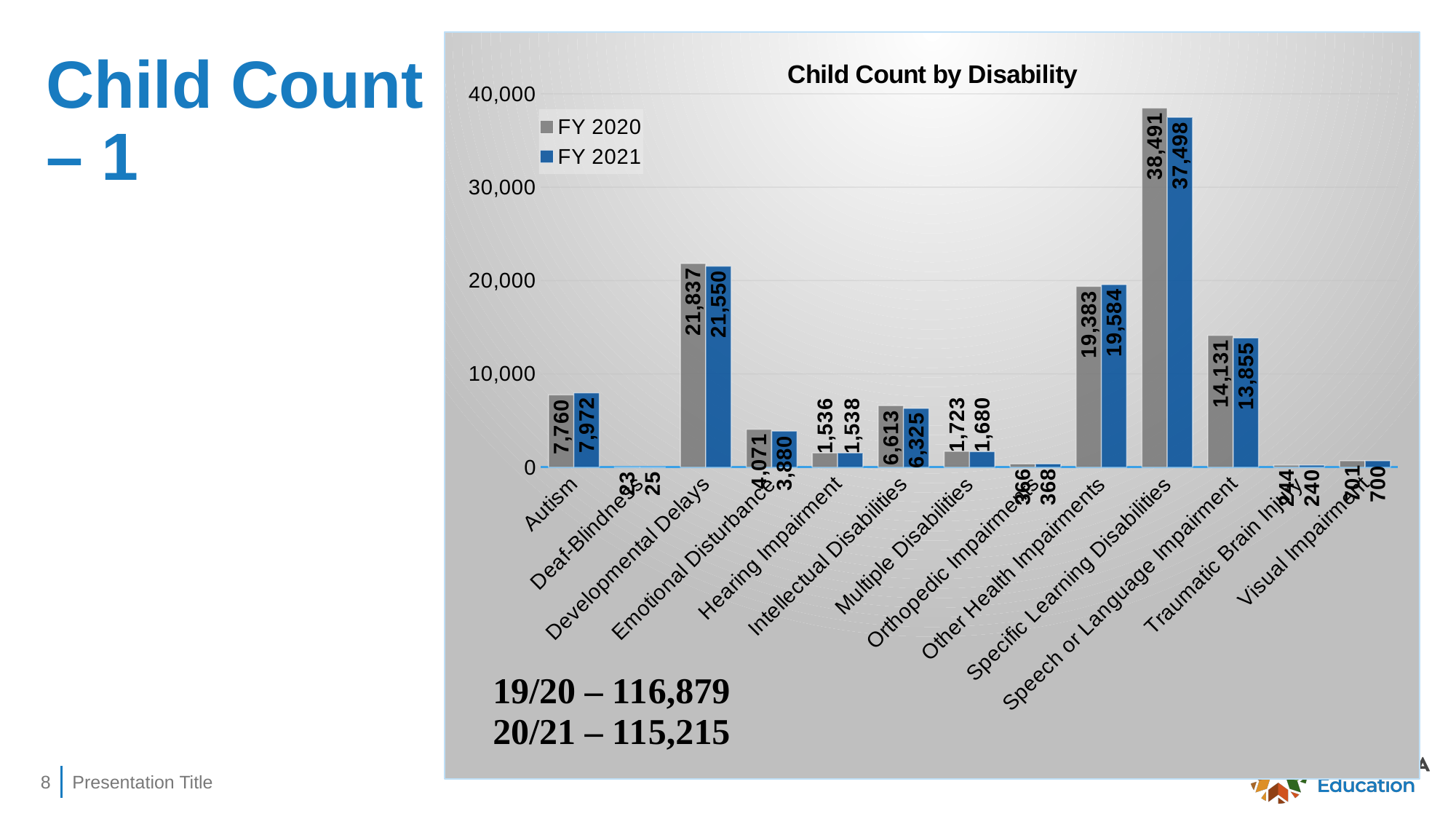
What kind of chart is shown on the slide? bar chart Is the FY 2021 child count for Speech or Language Impairment greater or less than 10,000? greater Which disability category has the highest FY 2021 child count? Specific Learning Disabilities For Other Health Impairments, which year has the larger child count, FY 2020 or FY 2021? FY 2021 How many series does the legend of the chart list? 2 What is the title of the chart? Child Count by Disability What is the difference between the FY 2020 and FY 2021 child counts for Developmental Delays? 287 What is the FY 2020 child count for Emotional Disturbance? 4,071 How many disability categories are shown on the x axis of the chart? 13 What is the FY 2020 child count for Specific Learning Disabilities? 38,491 What is the FY 2021 child count for Autism? 7,972 What is the FY 2021 child count for Traumatic Brain Injury? 240